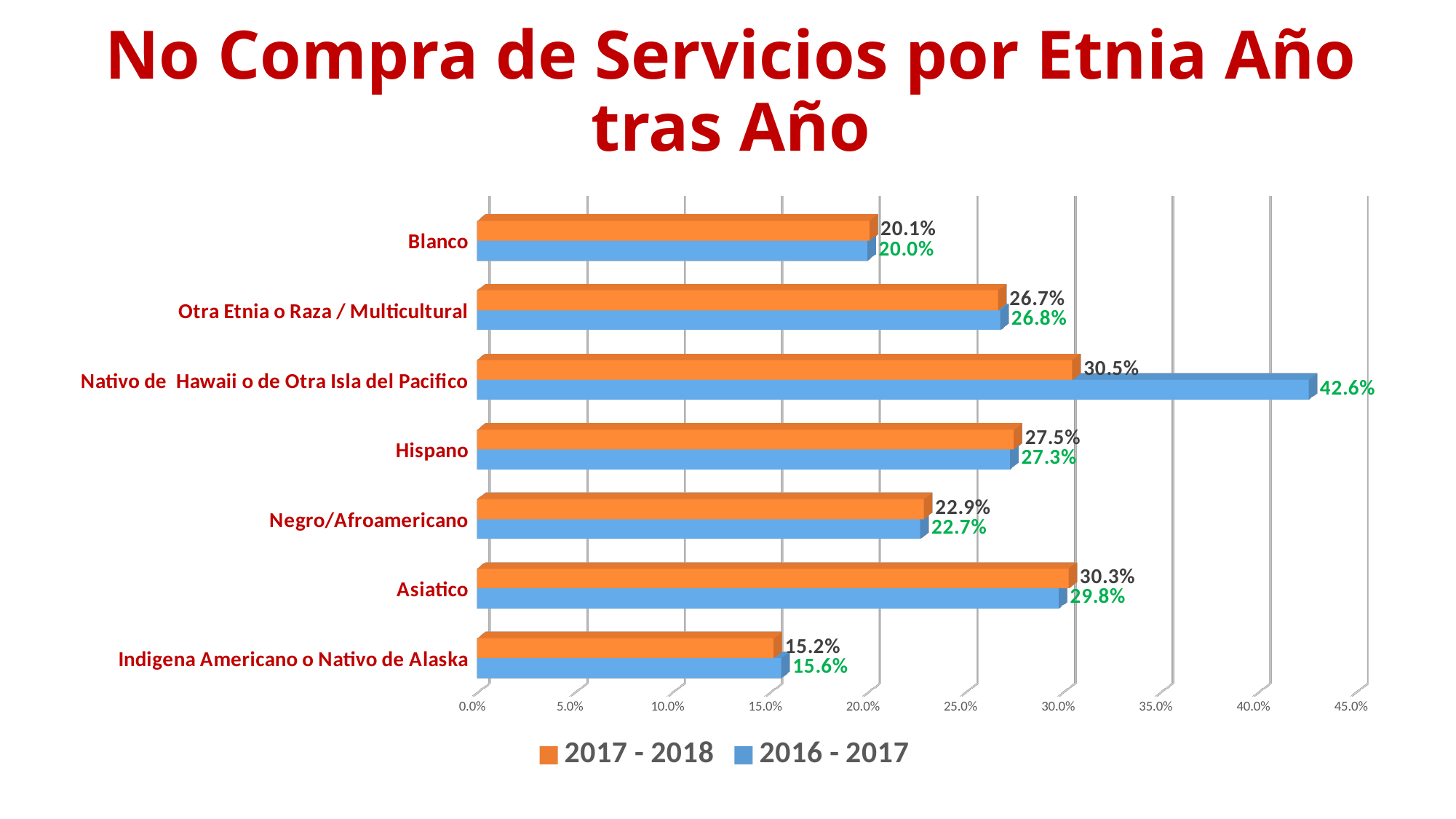
Which category has the highest 2016 - 2017 value? Nativo de Hawaii o de Otra Isla del Pacifico How many ethnic categories are shown on the chart? 7 What is the 2016 - 2017 value for Indigena Americano o Nativo de Alaska? 15.6% Which colour represents the 2016 - 2017 series? Blue Is the 2017 - 2018 value for Negro/Afroamericano greater or less than 25.0%? less What is the 2016 - 2017 value for Nativo de Hawaii o de Otra Isla del Pacifico? 42.6% Which is larger for Asiatico: the 2017 - 2018 value or the 2016 - 2017 value? 2017 - 2018 What kind of chart is shown on the slide? Bar chart What is the 2017 - 2018 value for Hispano? 27.5% Which category has the lowest 2017 - 2018 value? Indigena Americano o Nativo de Alaska How many series does the legend list? 2 What is the difference between the 2016 - 2017 and 2017 - 2018 values for Nativo de Hawaii o de Otra Isla del Pacifico? 12.1%